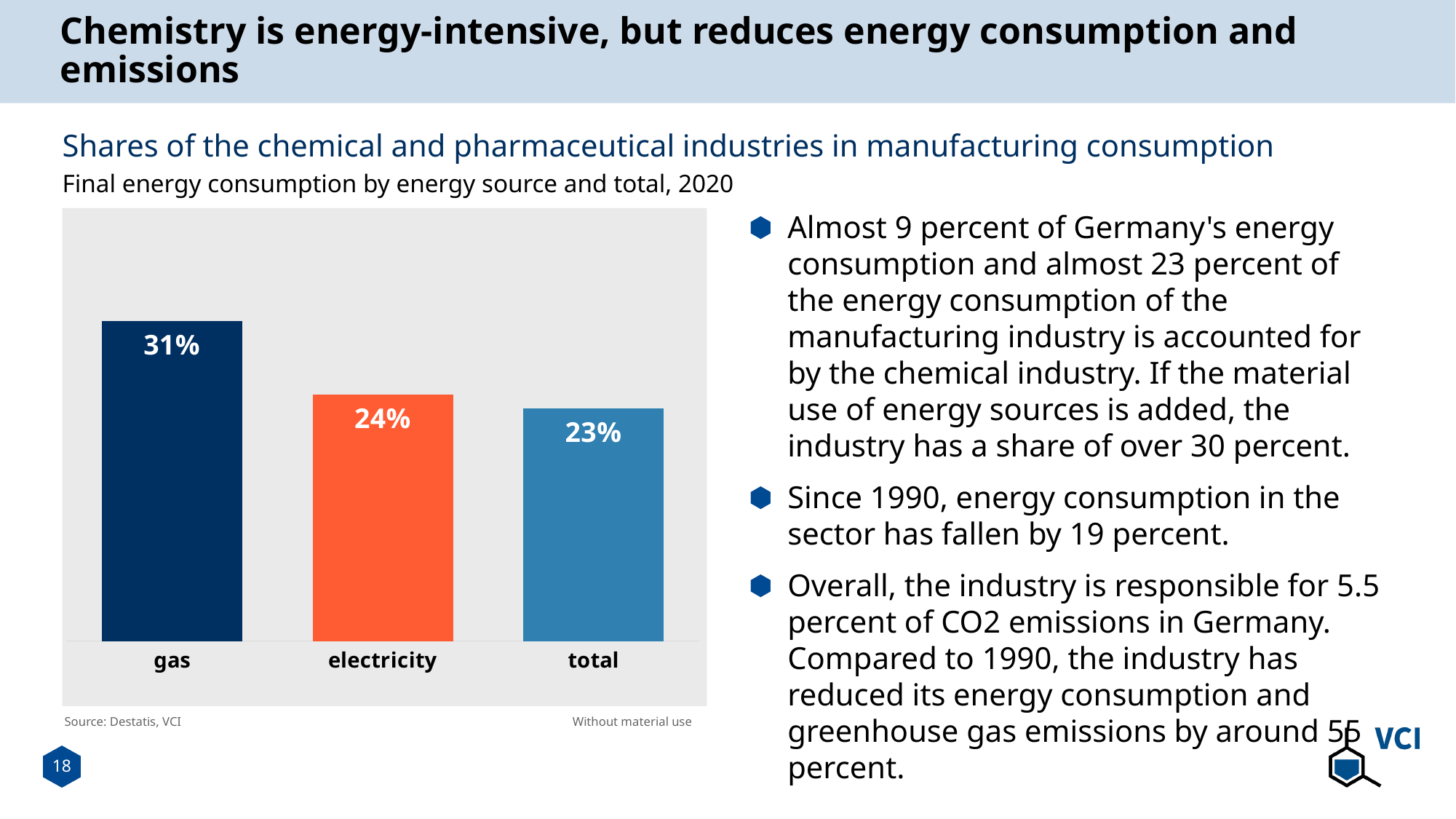
What is the value for gas? 31% What is the difference between the values for gas and electricity? 7% What kind of chart is shown on the slide? bar chart What is the difference between the values for gas and total? 8% What is the value for total? 23% Which category has the highest value? gas Which category has the lowest value? total Do the values rise or fall from left to right across the categories? fall How many categories are shown in the chart? 3 Which is larger, the value for gas or the value for total? gas What is the value for electricity? 24% What colour is the bar for electricity? orange